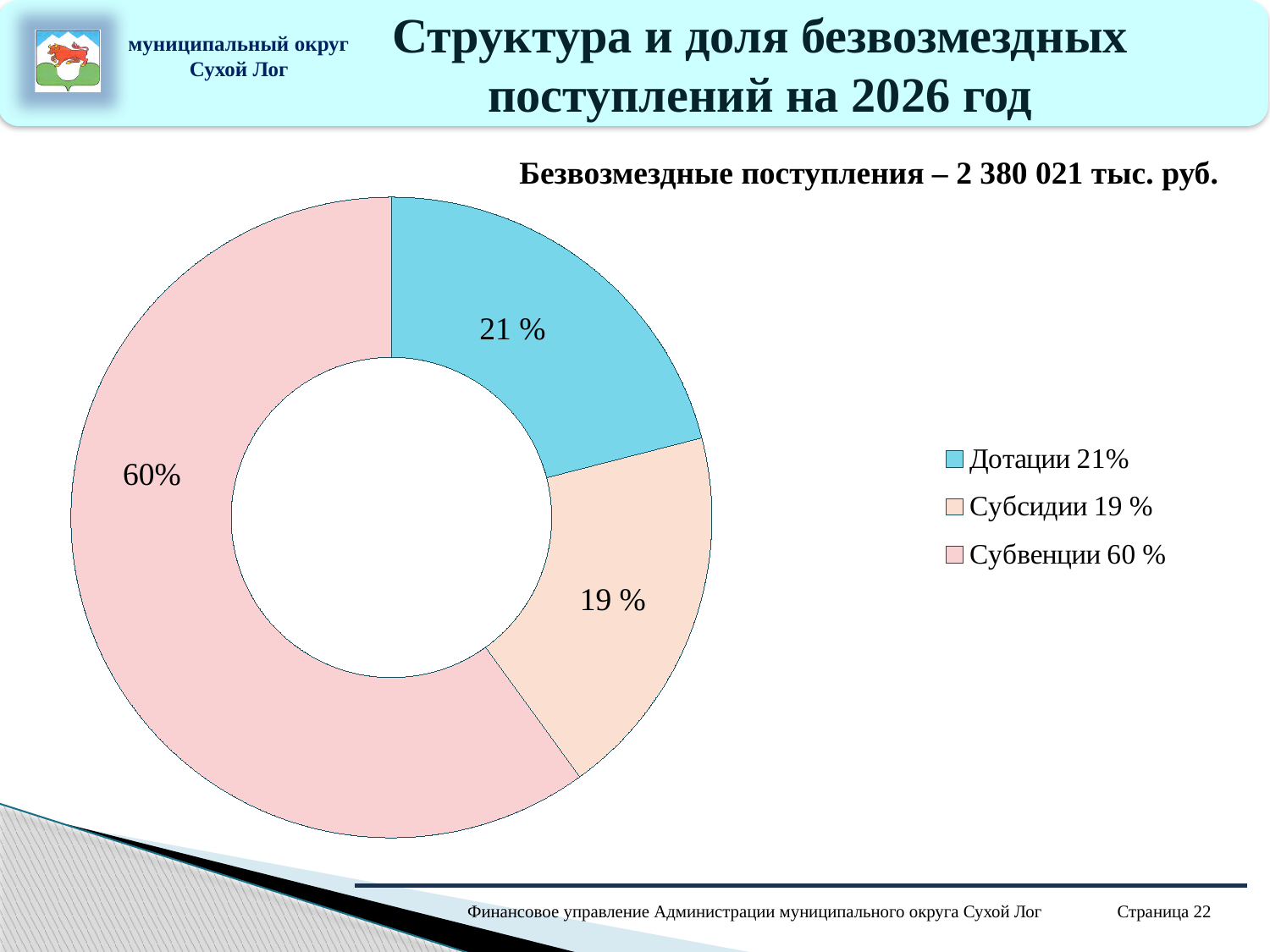
Which is larger, the share for Дотации or the share for Субсидии? Дотации Which category has the largest share of the chart? Субвенции What is the value shown for Дотации? 21 % What kind of chart is shown on the slide? Doughnut (pie) chart What is the value shown for Субсидии? 19 % What total amount of безвозмездные поступления is stated above the chart? 2 380 021 тыс. руб. Which category has the smallest share of the chart? Субсидии What is the difference in percentage points between Субвенции and Дотации? 39 What is the difference in percentage points between Дотации and Субсидии? 2 How many categories are shown in the chart? 3 What share of the pie does Субвенции take? 60% Which colour represents Дотации in the chart? Blue